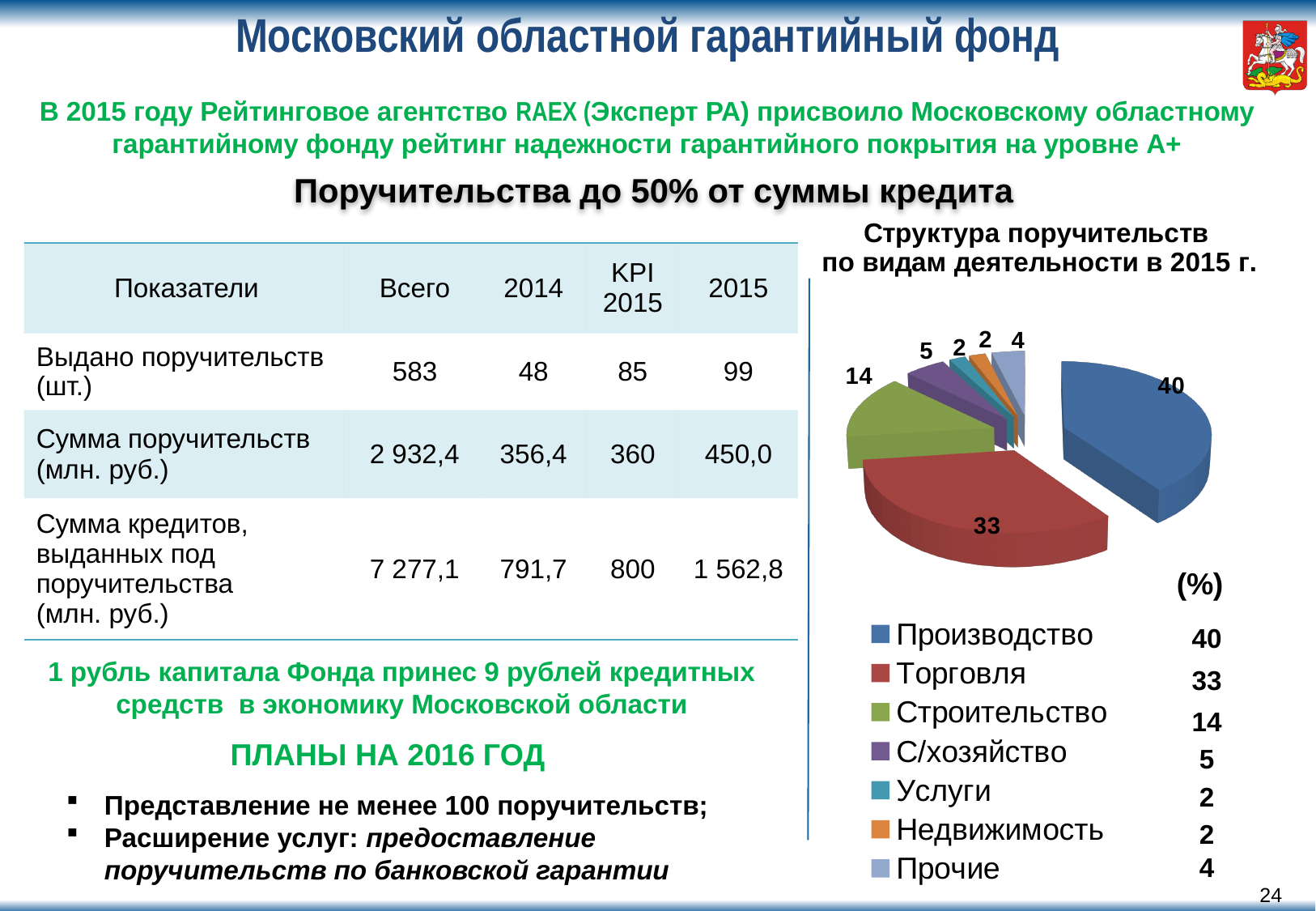
What is the value for Торговля in the pie chart? 33 What is the difference between the values for Производство and Торговля? 7 What kind of chart is shown on the slide? pie chart What is the value for Прочие in the pie chart? 4 What is the value for Производство in the pie chart? 40 What colour is the Торговля slice in the pie chart? red Which is larger, Строительство or С/хозяйство? Строительство What is the value for Строительство in the pie chart? 14 How many categories does the pie chart show? 7 What is the value for С/хозяйство in the pie chart? 5 What is the title of the pie chart? Структура поручительств по видам деятельности в 2015 г. Which category has the largest slice in the pie chart? Производство